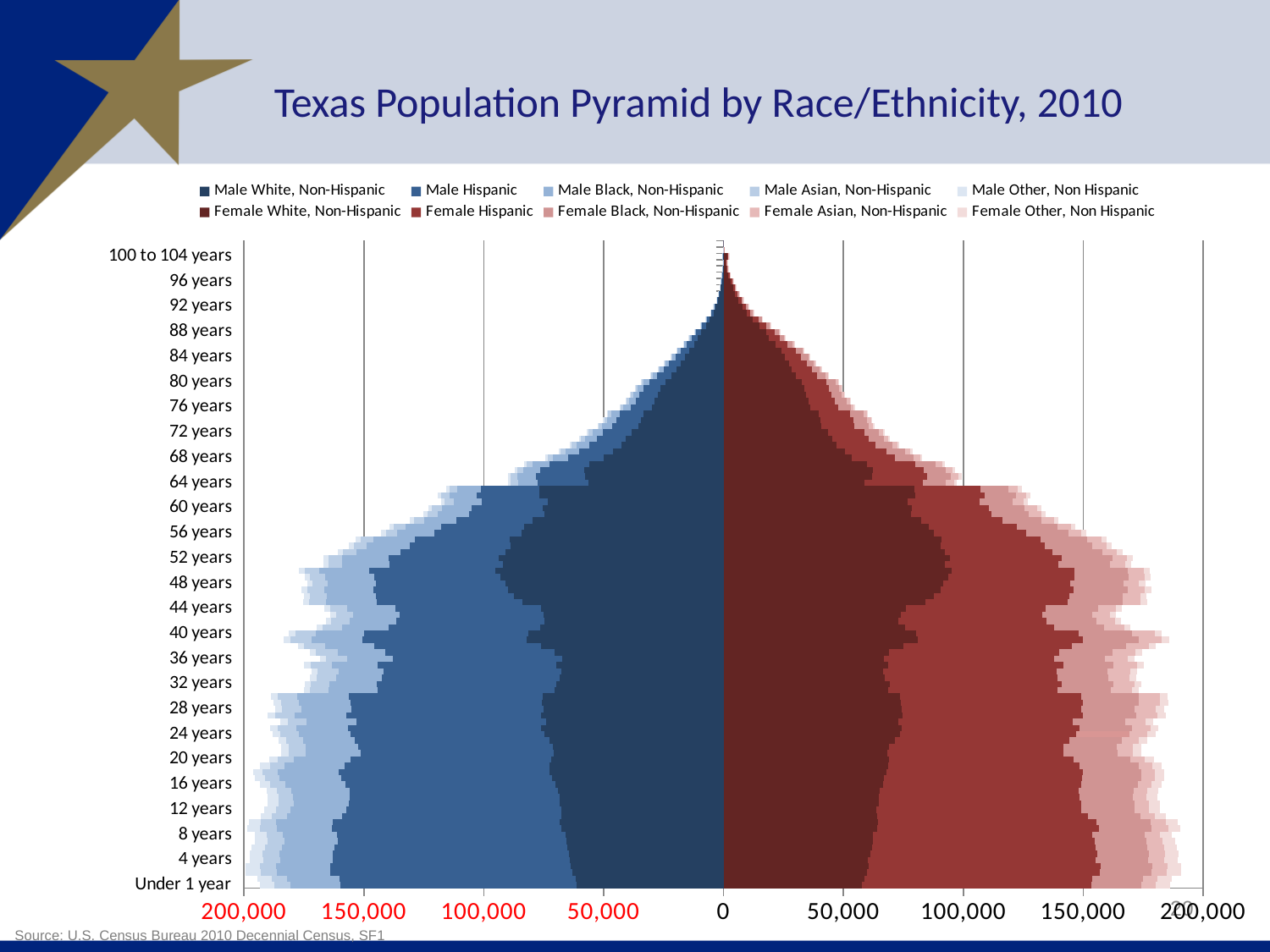
What is the title of the chart? Texas Population Pyramid by Race/Ethnicity, 2010 What kind of chart is shown on the slide? bar chart Is the total female population at 88 years greater or less than 50,000? less Moving from Under 1 year up to 100 to 104 years, do the bars generally get longer or shorter? shorter Is the total male population at 40 years greater or less than 150,000? greater How many series does the legend list? 10 Is the total male population at 88 years greater or less than 50,000? less What is the highest value shown on the horizontal axis? 200,000 Which colour family is used for the male series in the chart? blue